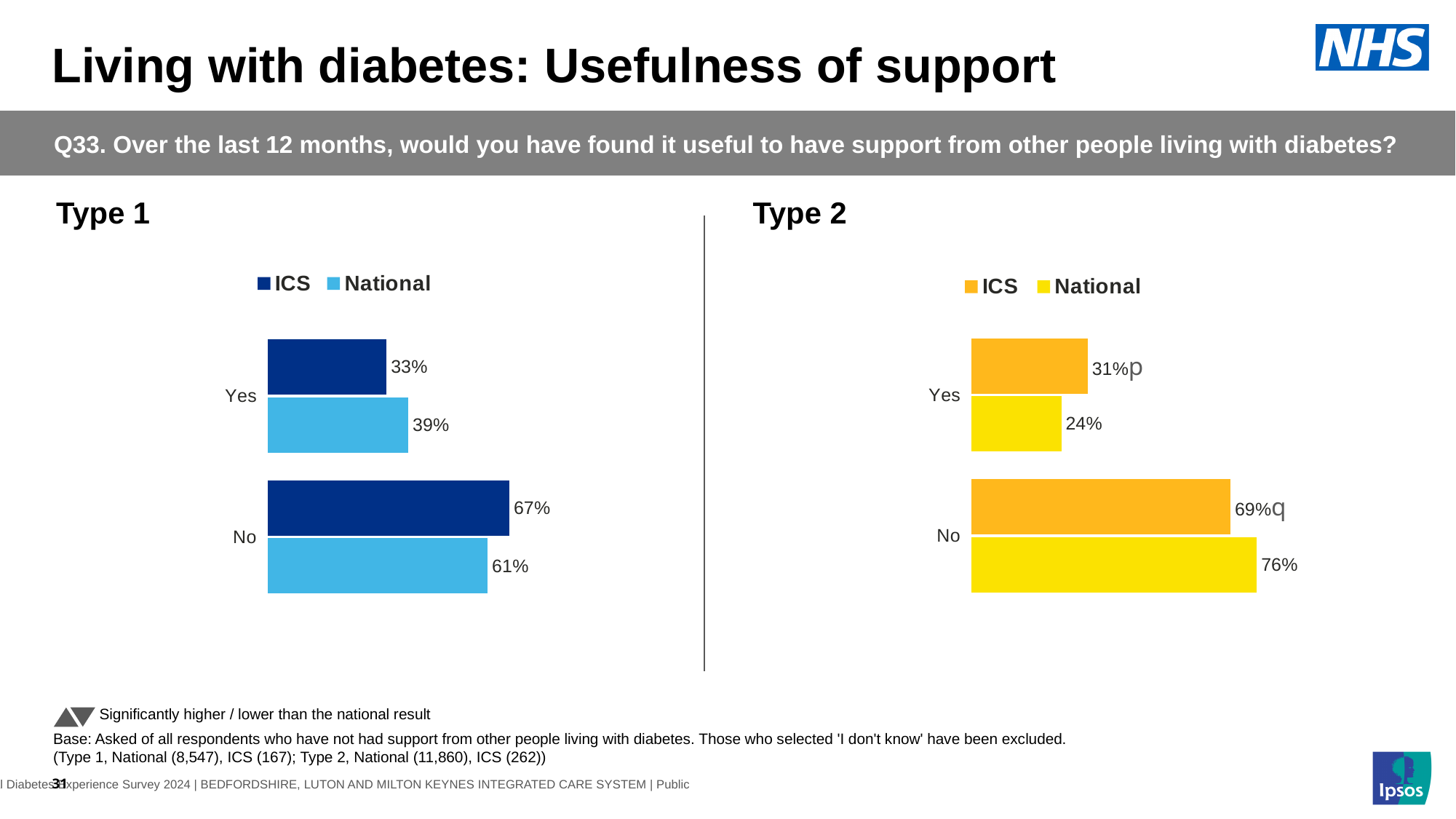
What type of chart is the Type 2 chart? Bar chart In the Type 2 chart, what is the ICS value for No? 69% How many series does the legend of the Type 1 chart list? 2 In the Type 2 chart, which is larger for No: ICS or National? National In the Type 1 chart, which bar has the lowest value? ICS, Yes (33%) In the Type 1 chart, which is larger for Yes: ICS or National? National In the Type 1 chart, what is the National value for No? 61% In the Type 1 chart, what is the difference between the ICS and National values for No? 6 percentage points In the Type 2 chart, what is the National value for Yes? 24% In the Type 2 chart, which bar has the highest value? National, No (76%) In the Type 1 chart, what is the ICS value for Yes? 33% In the Type 2 chart, what is the difference between the National and ICS values for Yes? 7 percentage points